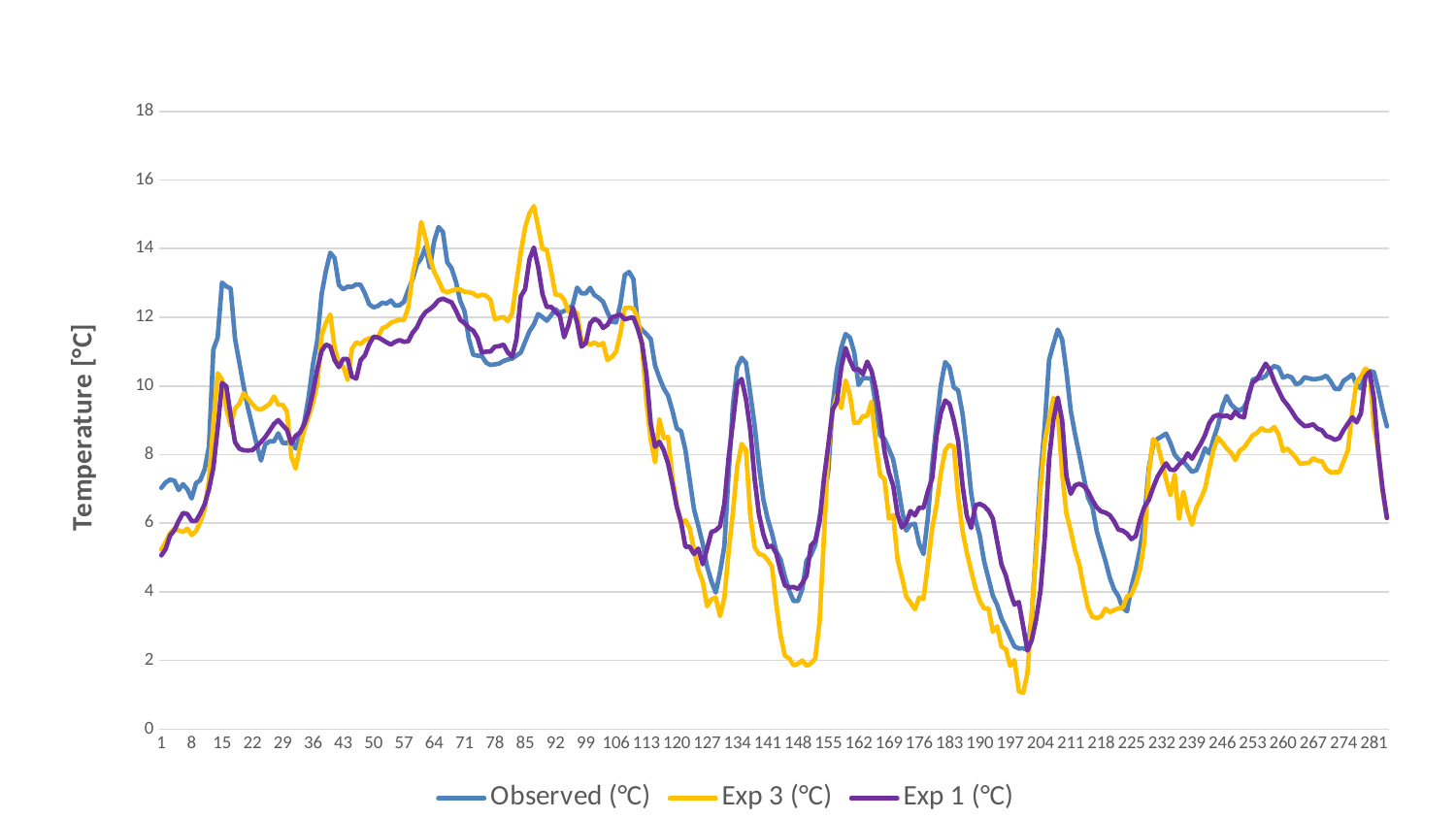
Which series reaches the highest peak value on the chart? Exp 3 (°C) Is the value of Exp 3 (°C) at x = 148 greater or less than 4? less How many series does the legend list? 3 Which series drops to the lowest value on the chart? Exp 3 (°C) Which series is drawn in purple according to the legend? Exp 1 (°C) Is the value of Observed (°C) at x = 1 greater or less than 6? greater What is the highest tick value shown on the vertical axis? 18 What kind of chart is shown on the slide? line chart Does the Observed (°C) series rise or fall between x = 113 and x = 127? fall What is the title of the vertical axis? Temperature [°C] Is the peak value of Exp 3 (°C) near x = 85–92 greater or less than 14? greater